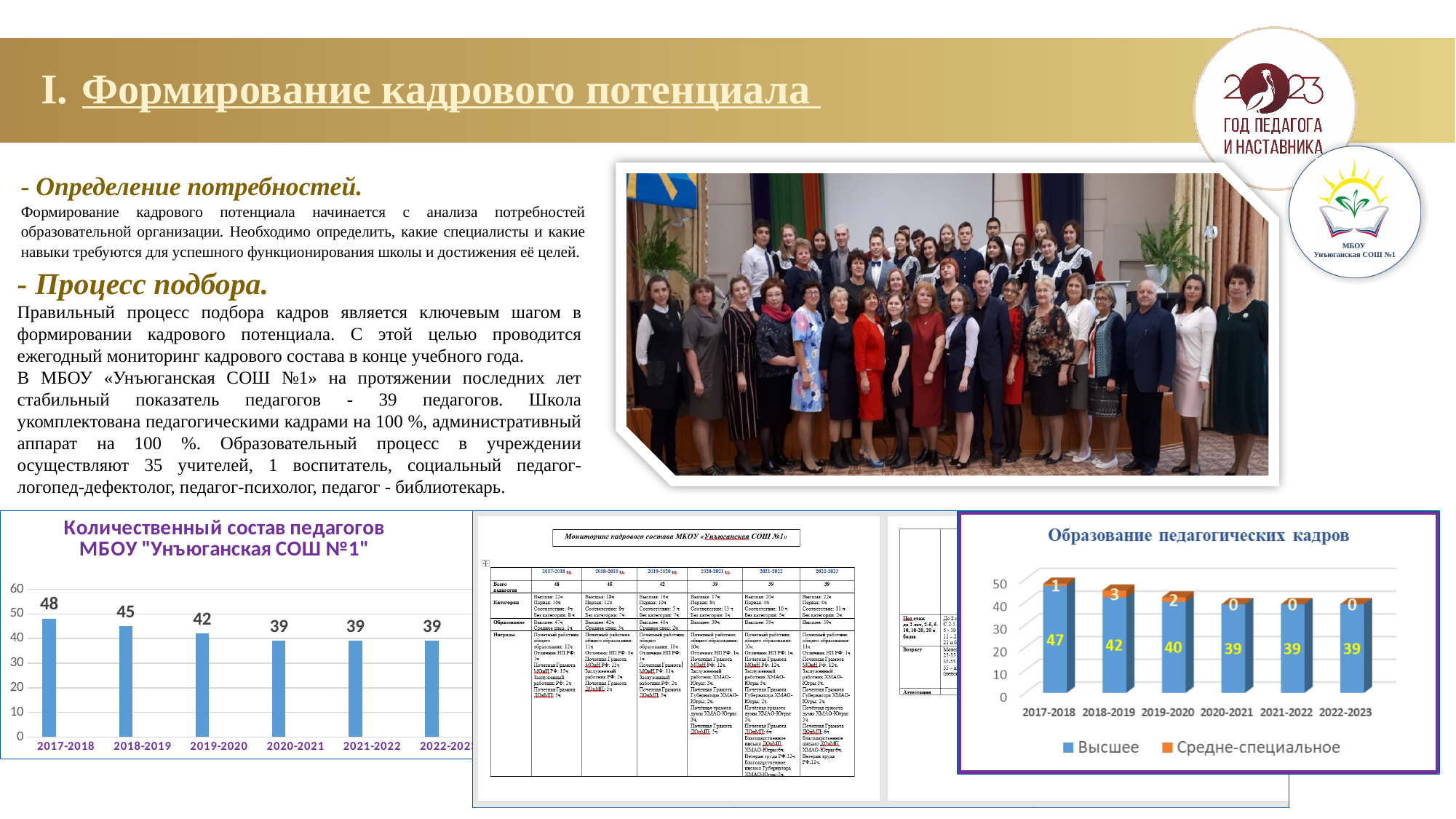
In the chart "Образование педагогических кадров", what is the total of the stacked bar for 2019-2020? 42 In the chart "Образование педагогических кадров", what is the value of Высшее for 2017-2018? 47 In the chart "Образование педагогических кадров", what is the value of Средне-специальное for 2018-2019? 3 In the chart "Количественный состав педагогов МБОУ "Унъюганская СОШ №1"", do the values rise or fall from 2017-2018 to 2020-2021? fall In the chart "Количественный состав педагогов МБОУ "Унъюганская СОШ №1"", what is the value for 2019-2020? 42 What kind of chart is "Количественный состав педагогов МБОУ "Унъюганская СОШ №1""? bar chart In the chart "Образование педагогических кадров", which series is shown in orange? Средне-специальное In the chart "Образование педагогических кадров", how many series does the legend list? 2 In the chart "Количественный состав педагогов МБОУ "Унъюганская СОШ №1"", which year has the highest value? 2017-2018 In the chart "Количественный состав педагогов МБОУ "Унъюганская СОШ №1"", what is the difference between the values for 2017-2018 and 2018-2019? 3 In the chart "Количественный состав педагогов МБОУ "Унъюганская СОШ №1"", what is the value for 2017-2018? 48 In the chart "Количественный состав педагогов МБОУ "Унъюганская СОШ №1"", how many years are shown on the x axis? 6